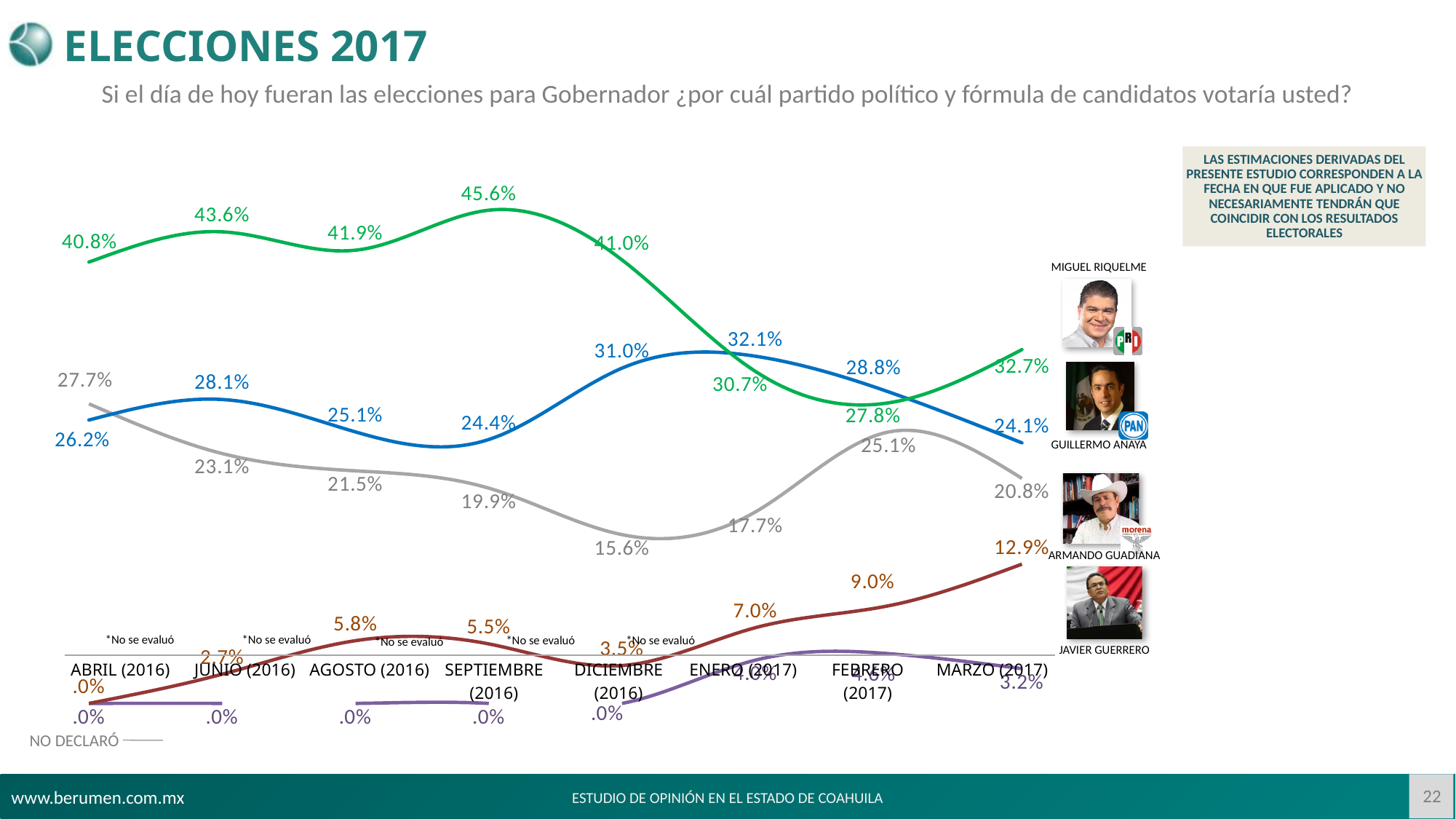
What is the value of the blue line at ENERO (2017)? 32.1% At which time point does the green line reach its highest value? SEPTIEMBRE (2016) Does the brown line rise or fall from DICIEMBRE (2016) to MARZO (2017)? Rises At which time point does the gray line reach its lowest value? DICIEMBRE (2016) What is the value of the gray line at DICIEMBRE (2016)? 15.6% At ENERO (2017), which is larger: the blue line or the green line? The blue line (32.1%) How many time points are plotted along the x axis of the chart? 8 What is the value of the green line at SEPTIEMBRE (2016)? 45.6% What kind of chart is shown on the slide? Line chart At MARZO (2017), what is the difference between the green line (32.7%) and the blue line (24.1%)? 8.6 percentage points According to the legend at the bottom left, what does the gray line represent? NO DECLARÓ What is the value of the brown line at MARZO (2017)? 12.9%